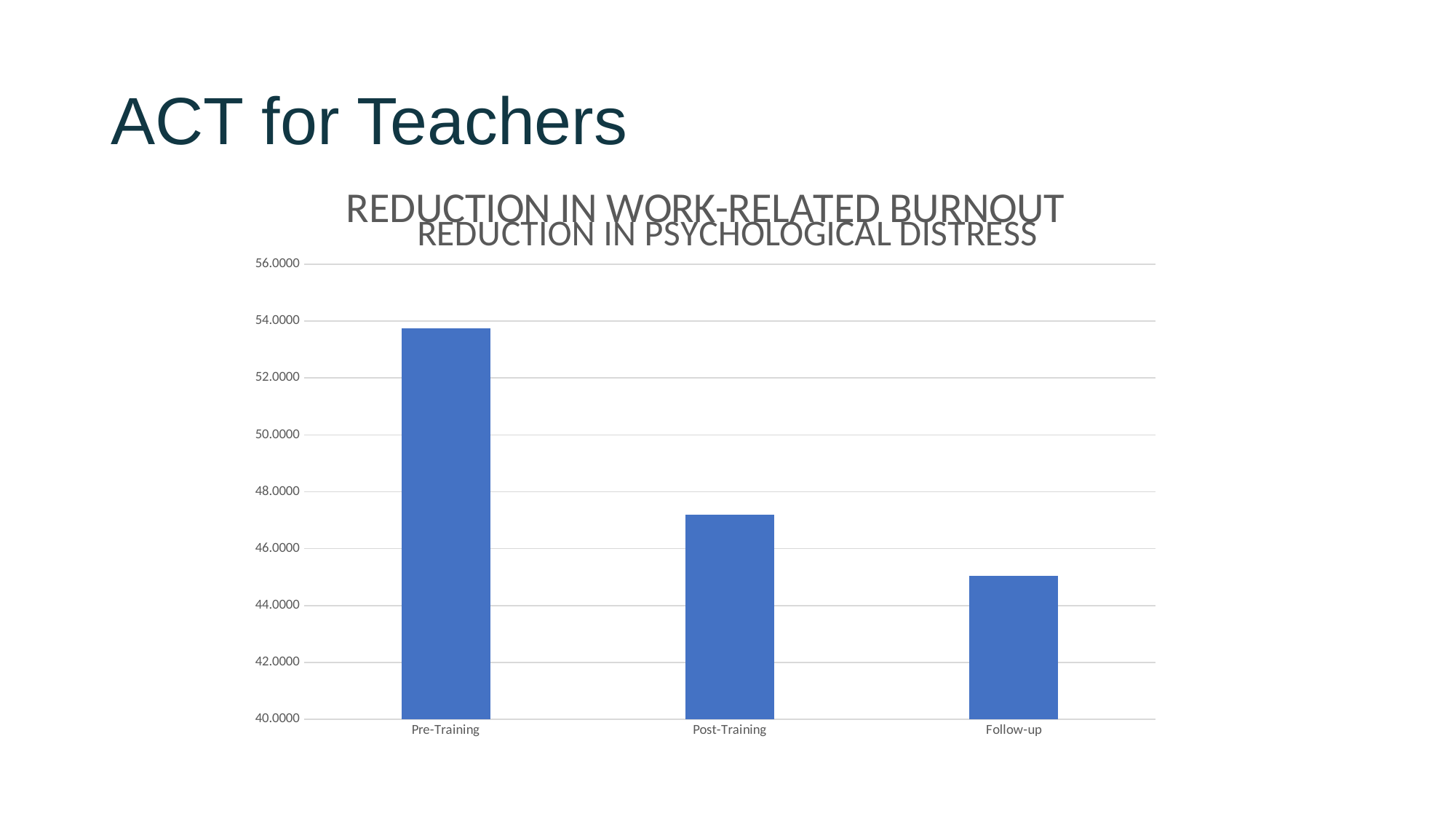
Is the value for Follow-up greater or less than 44.0000? greater What kind of chart is shown on the slide? bar chart Is the value for Pre-Training greater or less than 52.0000? greater Which is larger, the value for Pre-Training or the value for Post-Training? Pre-Training Which category has the highest value in the chart? Pre-Training Which is larger, the value for Post-Training or the value for Follow-up? Post-Training Which category has the lowest value in the chart? Follow-up Is the value for Follow-up greater or less than 46.0000? less How many categories are plotted on the x axis of the chart? 3 Do the values rise or fall from Pre-Training to Follow-up along the x axis? fall What is the label of the first category on the x axis of the chart? Pre-Training